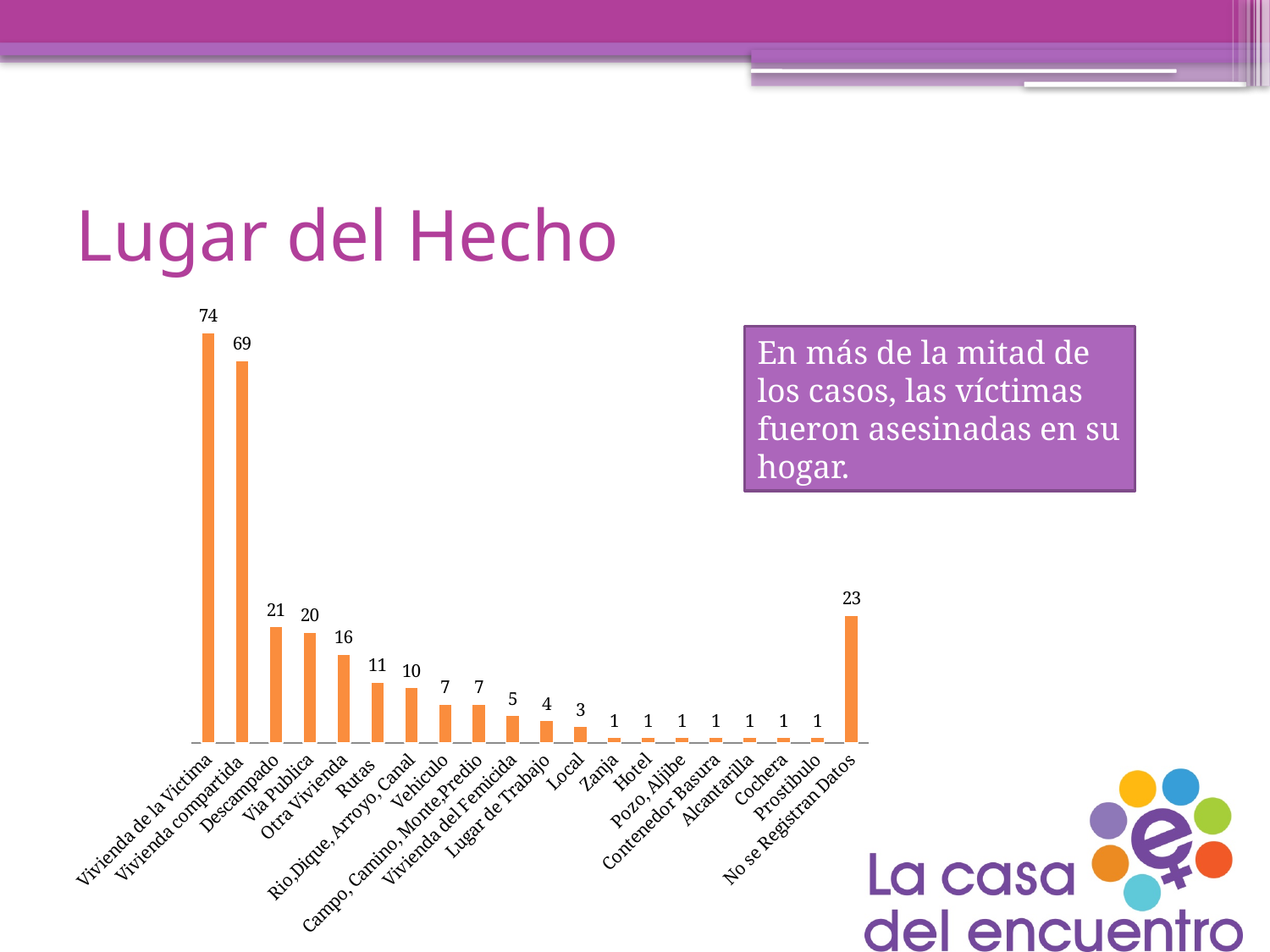
How many categories are shown on the chart? 20 Which is larger, the value for Otra Vivienda or the value for No se Registran Datos? No se Registran Datos What is the difference between the values for Descampado and Via Publica? 1 What is the title of the slide containing the chart? Lugar del Hecho What is the value for Vivienda de la Victima? 74 Which category has the highest value? Vivienda de la Victima What is the value for No se Registran Datos? 23 What is the value for Rutas? 11 Which is larger, the value for Vehiculo or the value for Local? Vehiculo What is the difference between the values for Vivienda de la Victima and Vivienda compartida? 5 What is the value for Descampado? 21 What kind of chart is shown on the slide? bar chart